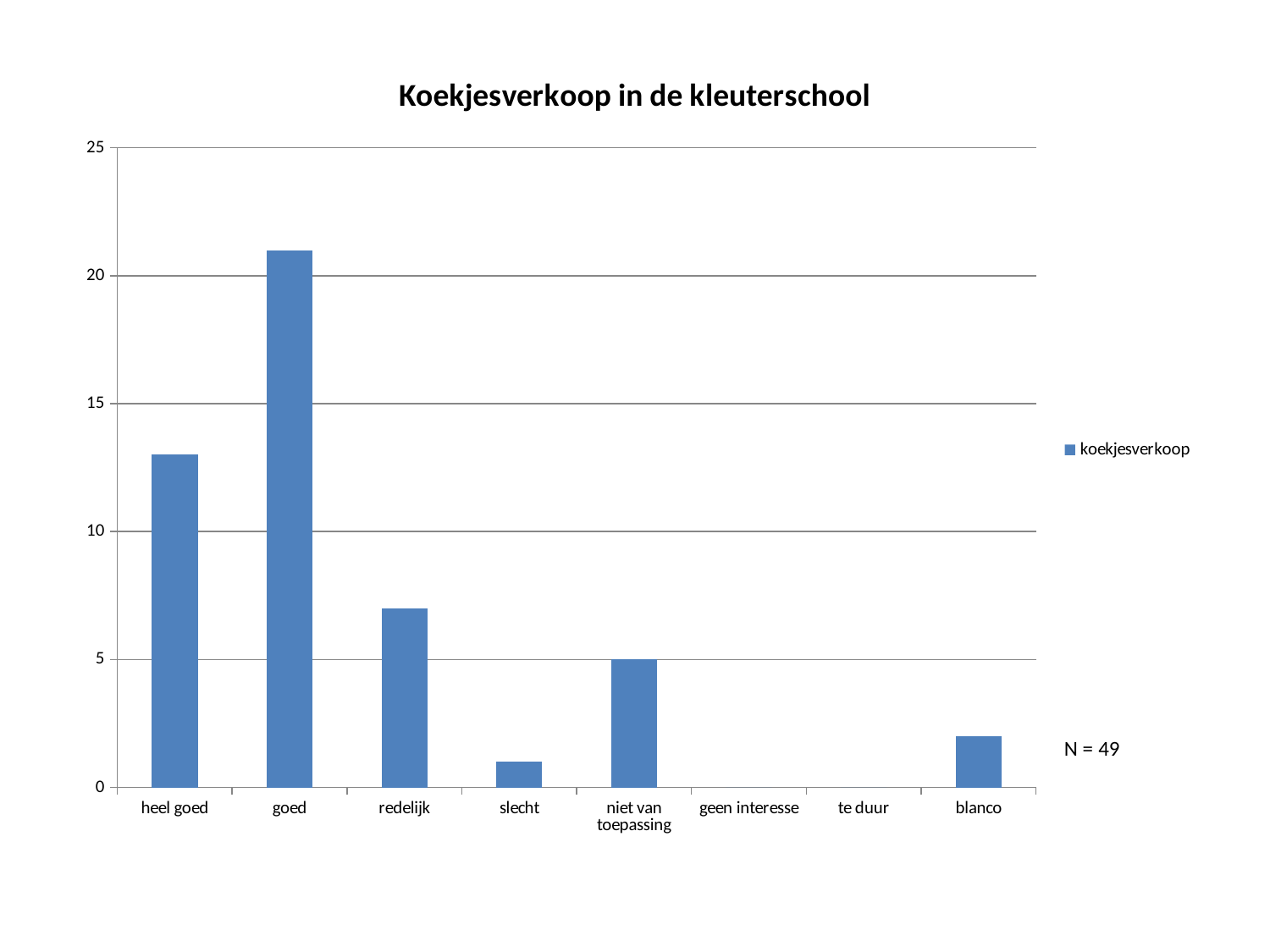
How many series does the legend list? 1 What is the value for niet van toepassing? 5 What series name is shown in the legend? koekjesverkoop Is the value for goed greater or less than 20? greater What kind of chart is shown on the slide? bar chart What is the title of the chart? Koekjesverkoop in de kleuterschool Which is larger, the value for heel goed or the value for redelijk? heel goed How many categories are shown on the x axis? 8 Which category has the highest value? goed Is the value for heel goed greater or less than 10? greater Is the value for blanco greater or less than 5? less